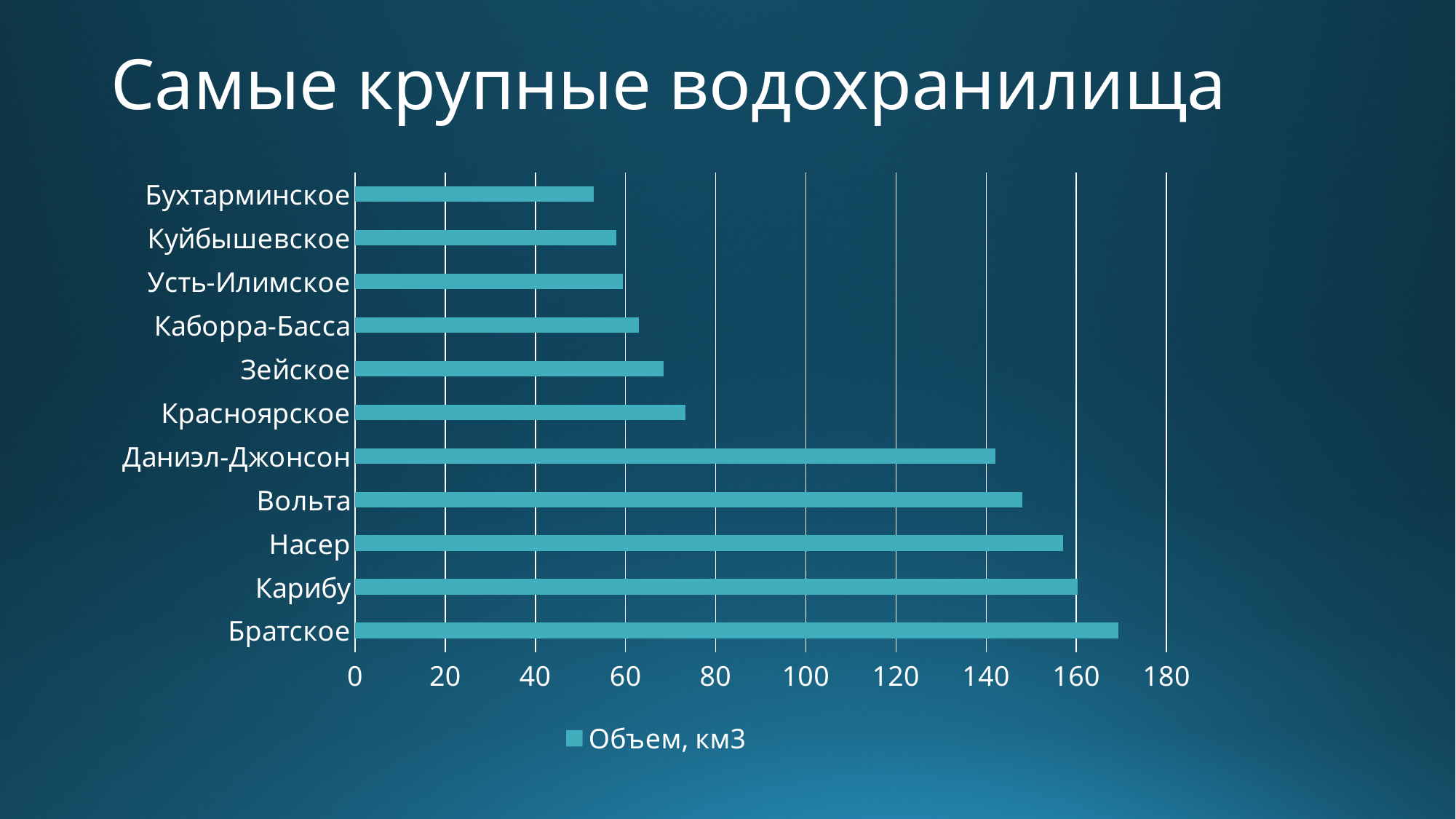
Which reservoir has the highest value in the chart? Братское What is the legend entry of the chart? Объем, км3 Which reservoir has the lowest value in the chart? Бухтарминское Which is larger, the value for Красноярское or the value for Зейское? Красноярское Is the value for Бухтарминское greater or less than 60? less Is the value for Даниэл-Джонсон greater or less than 140? greater How many reservoirs are shown in the chart? 11 Is the value for Красноярское greater or less than 80? less How many series does the legend list? 1 What kind of chart is shown on the slide? bar chart Which is larger, the value for Братское or the value for Карибу? Братское